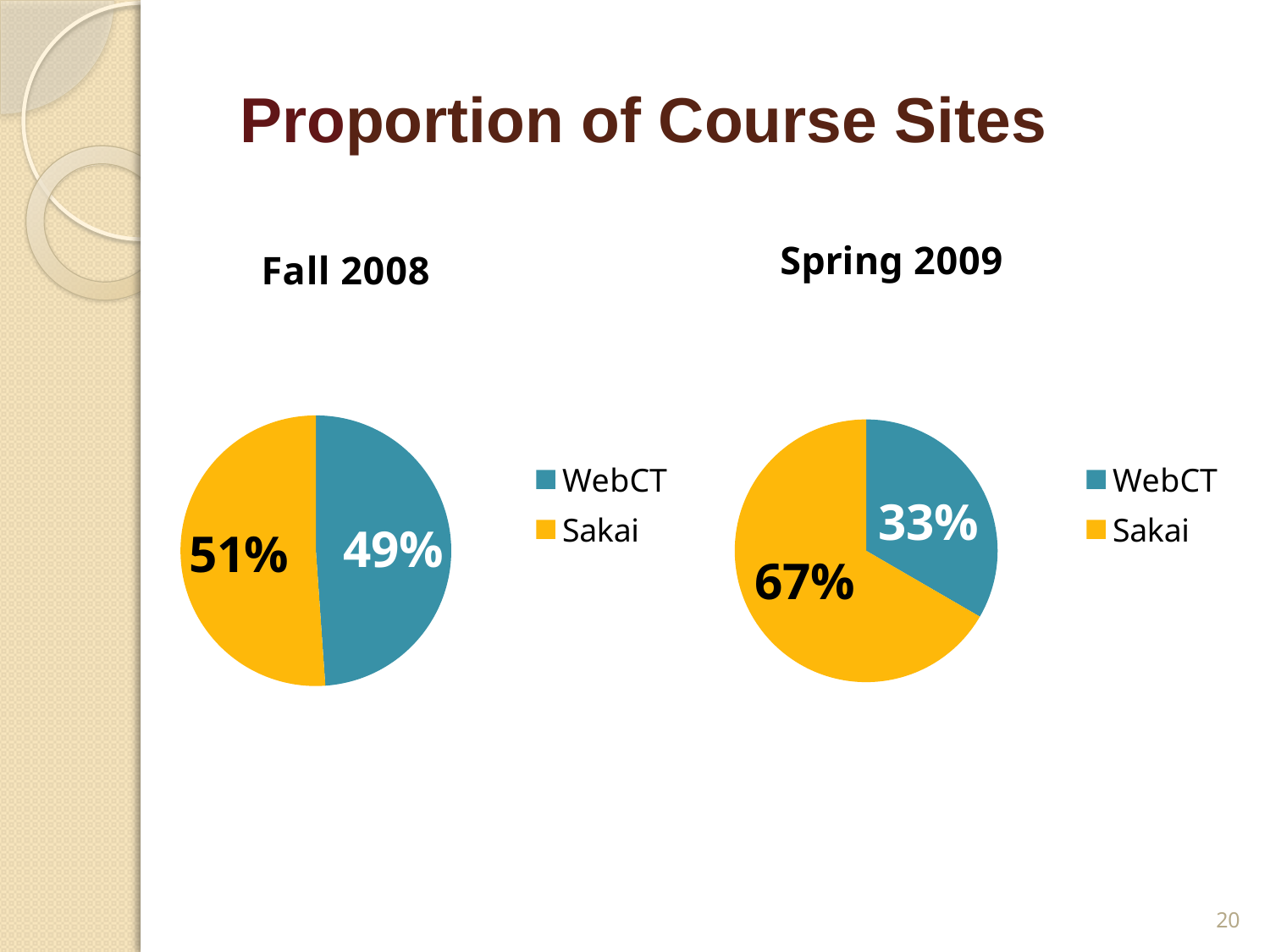
In the Fall 2008 chart, what is the difference between the Sakai and WebCT shares? 2% In the Fall 2008 chart, what share of course sites is WebCT? 49% In the Spring 2009 chart, which category has the smallest slice? WebCT In the Fall 2008 chart, what share of course sites is Sakai? 51% In the Spring 2009 chart, what share of course sites is WebCT? 33% How many categories does the legend of the Spring 2009 chart list? 2 In the Fall 2008 chart, what colour represents Sakai? Yellow Is the WebCT share larger in the Fall 2008 chart or the Spring 2009 chart? Fall 2008 In the Spring 2009 chart, what share of course sites is Sakai? 67% In the Spring 2009 chart, which category has the largest slice? Sakai What type of chart is used for Fall 2008? Pie chart In the Spring 2009 chart, what is the difference between the Sakai and WebCT shares? 34%